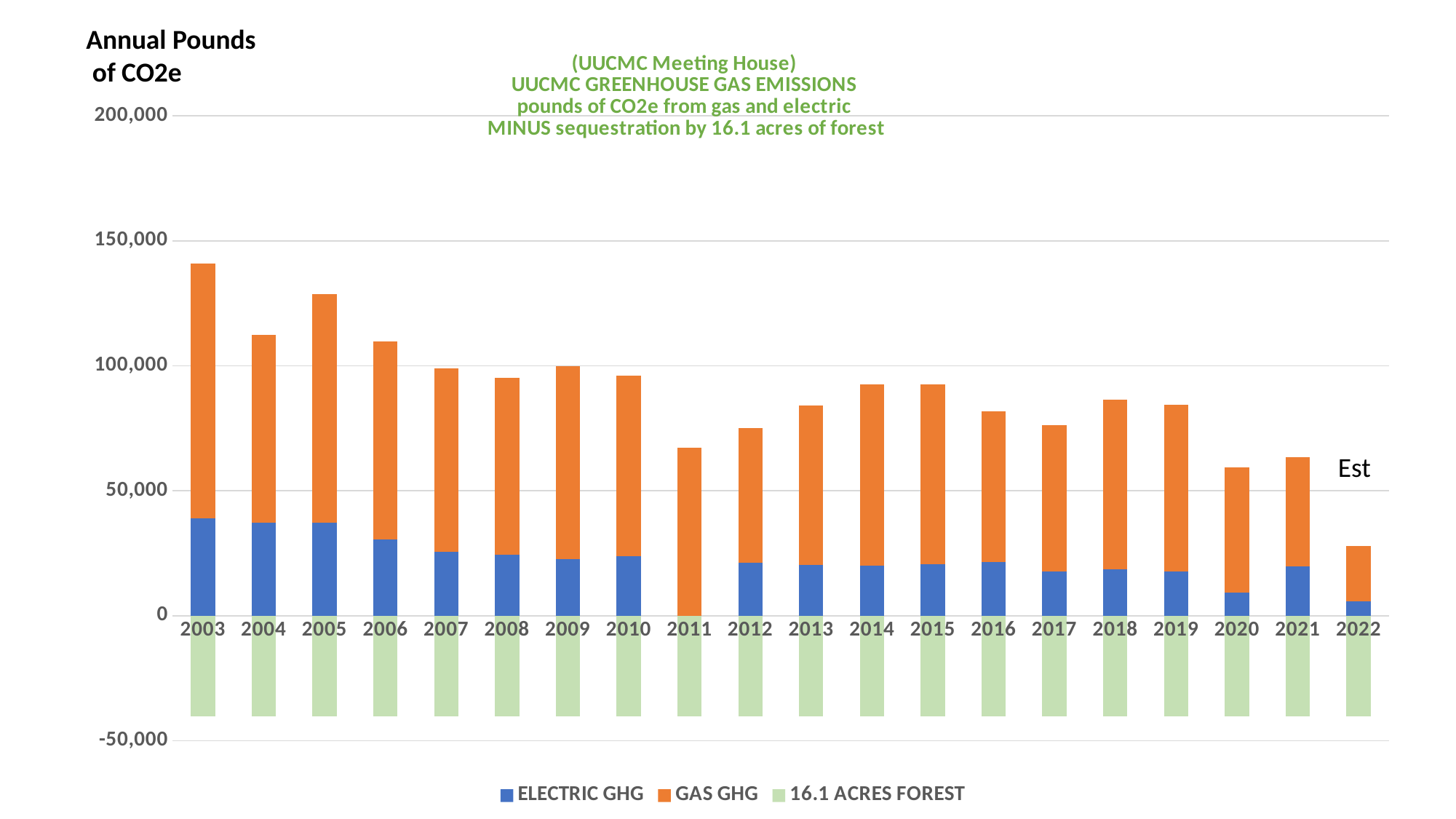
How many years are shown on the x axis? 20 Is the total emissions bar for 2003 greater or less than 100,000? greater Which year has the larger total emissions bar, 2003 or 2005? 2003 Is the total emissions bar for 2022 greater or less than 50,000? less Is the ELECTRIC GHG value for 2003 greater or less than 50,000? less Do total emissions generally rise or fall from 2003 to 2022? fall Which legend entry is shown in green? 16.1 ACRES FOREST Which year has the shortest stacked bar above zero (lowest total emissions)? 2022 What kind of chart is shown on the slide? stacked bar chart Which year has the tallest stacked bar above zero (highest total emissions)? 2003 How many series does the legend list? 3